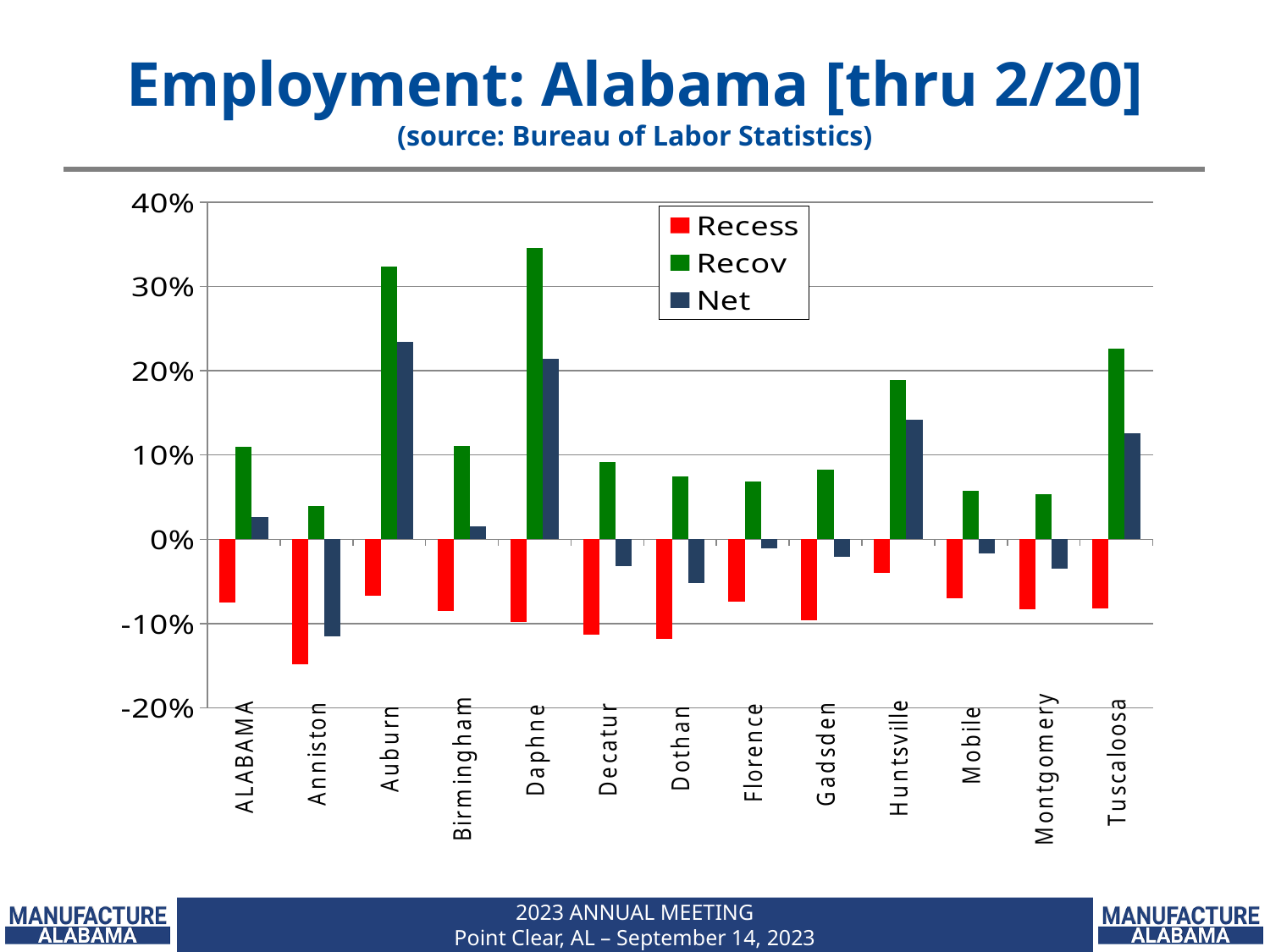
How many categories are shown along the x axis? 13 Which category has the lowest Net value? Anniston Which category has the highest Recov value? Daphne Is the Recess value for Anniston greater or less than -10%? less How many series does the legend list? 3 What colour represents the Recov series in the legend? green Which has the larger Recov value, Auburn or Huntsville? Auburn Is the Recov value for Mobile greater or less than 10%? less Which category has the lowest Recess value? Anniston Which category has the highest Net value? Auburn Is the Recov value for Auburn greater or less than 30%? greater What kind of chart is shown on the slide? bar chart